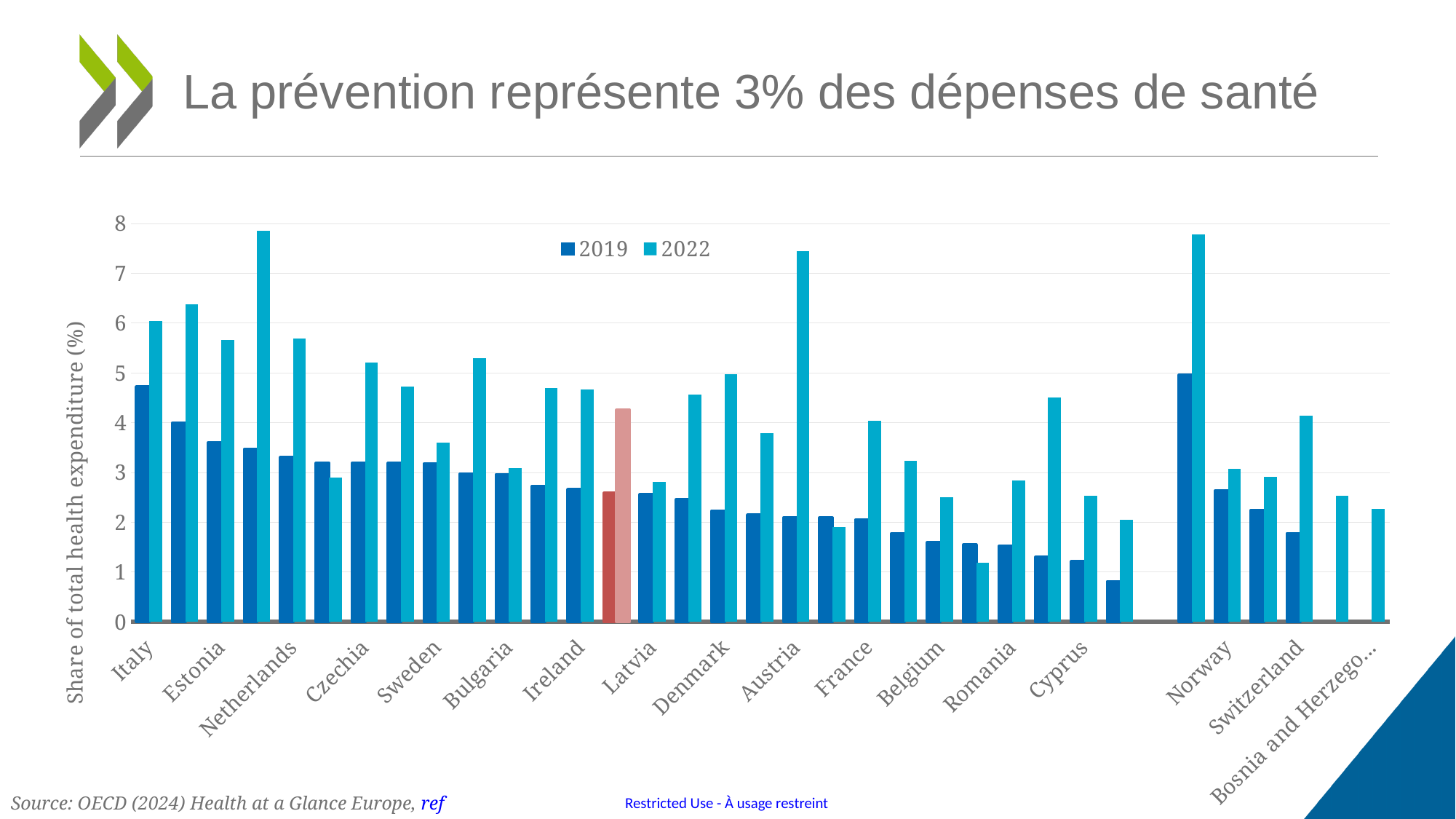
For Italy, which is larger: the 2019 value or the 2022 value? 2022 Is the 2022 value for Estonia greater or less than 5? greater What kind of chart is shown on the slide? Bar chart How many series does the legend list? 2 What are the two series named in the legend? 2019 and 2022 Which has the larger 2022 value: Denmark or Latvia? Denmark Is the 2019 value for Romania greater or less than 2? less Is the 2022 value for Czechia greater or less than 4? greater What is the label of the vertical axis? Share of total health expenditure (%)